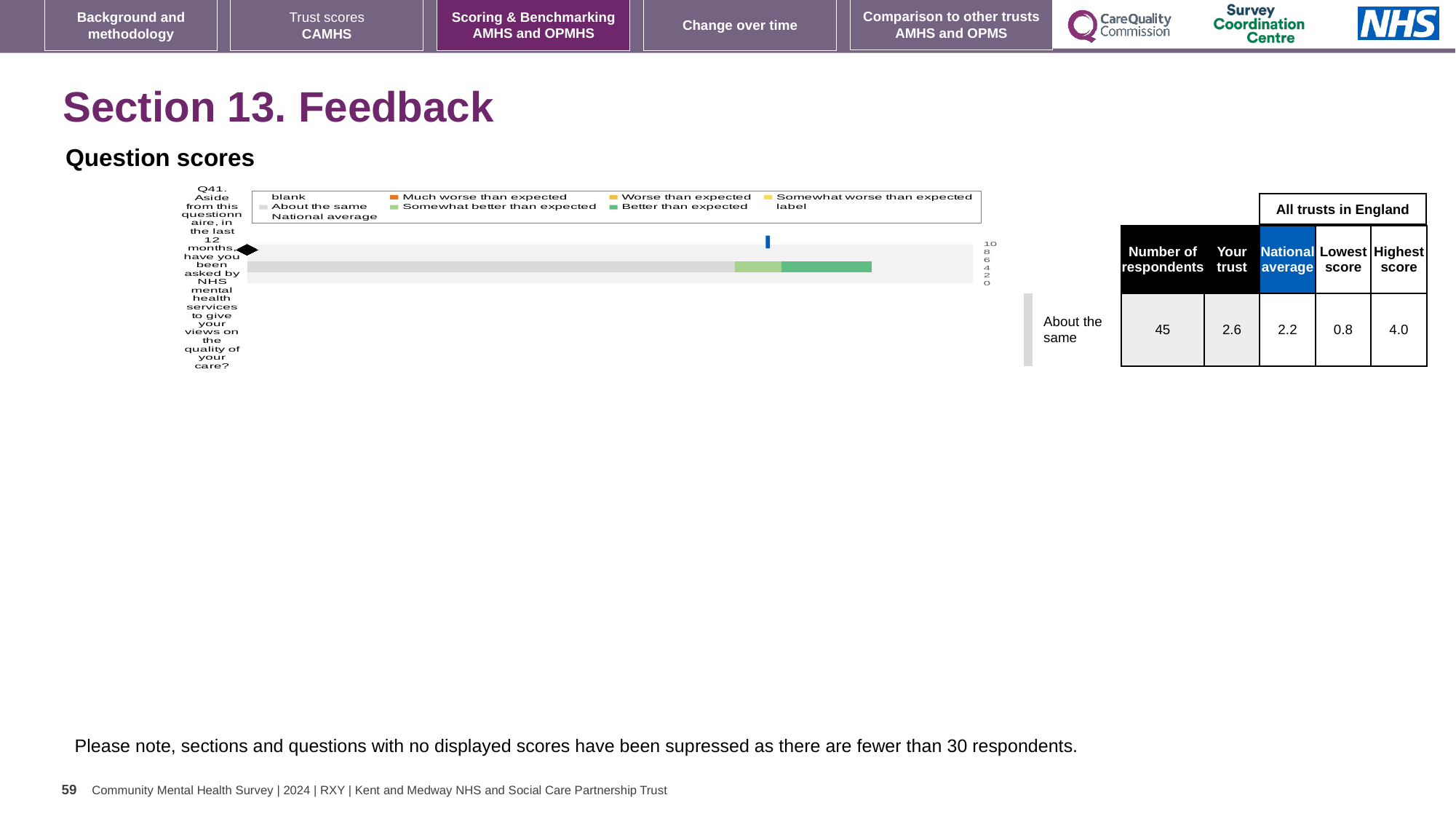
Which question number is plotted in the chart? Q41 In the table beside the chart, what is the number of respondents for Q41? 45 For Q41, which is larger: the 'Your trust' score or the National average score? Your trust In the table beside the chart, what is the highest score among all trusts in England for Q41? 4.0 What kind of chart is shown for Q41 on the slide? bar chart In the table beside the chart, what is the 'Your trust' score for Q41? 2.6 How many survey questions are plotted in the chart? 1 For Q41, what is the difference between the 'Your trust' score and the National average score? 0.4 In the table beside the chart, what is the National average score for Q41? 2.2 What benchmark category label is shown next to the chart for Q41? About the same For Q41, what is the difference between the highest score and the lowest score among all trusts in England? 3.2 In the table beside the chart, what is the lowest score among all trusts in England for Q41? 0.8